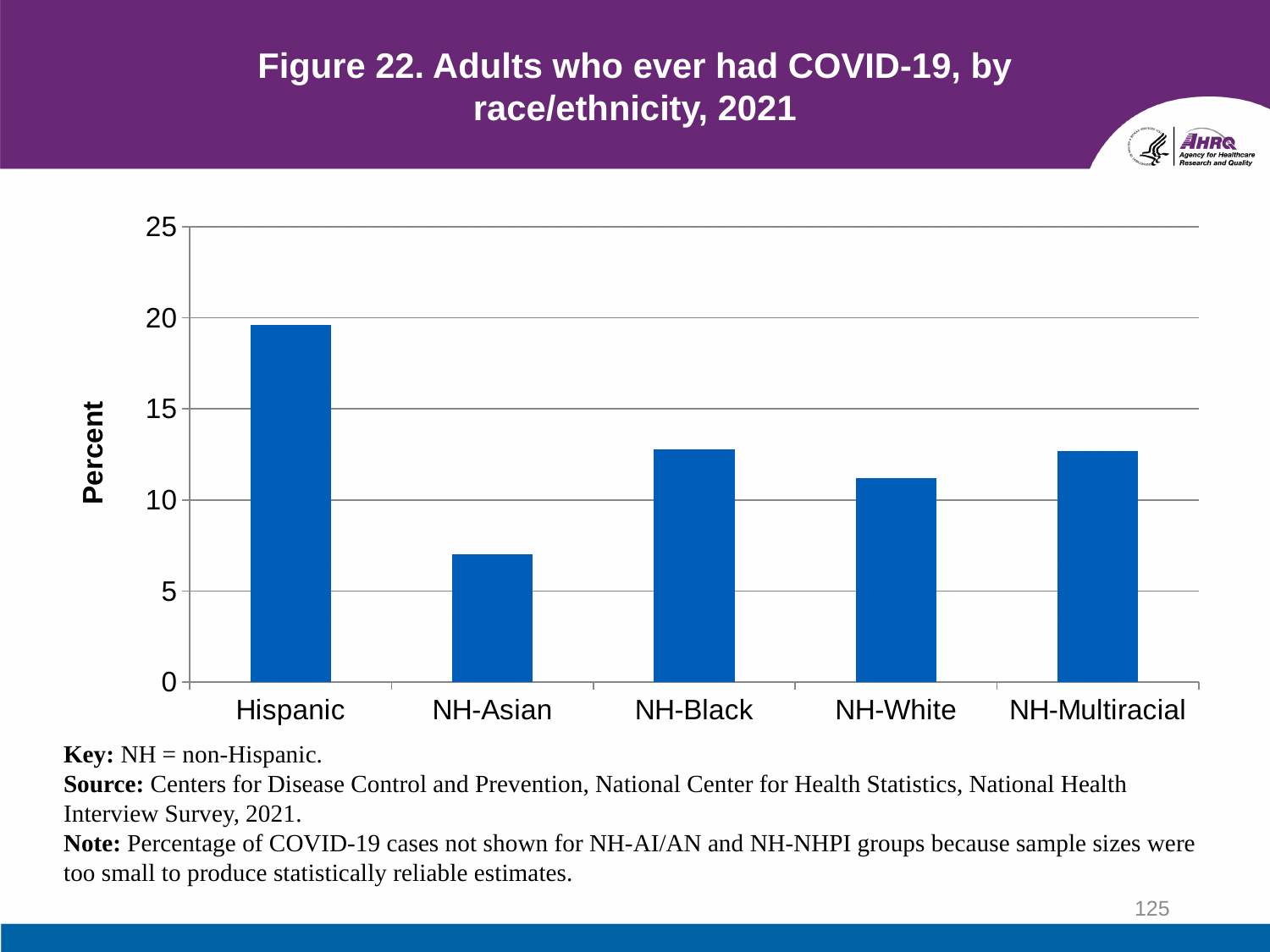
Is the value for NH-Asian greater or less than 10? less Which race/ethnicity group has the lowest percentage of adults who ever had COVID-19? NH-Asian What is the label on the vertical axis of the chart? Percent Which is larger, the value for NH-Asian or the value for NH-Black? NH-Black What kind of chart is shown on the slide? Bar chart Is the value for Hispanic greater or less than 15? greater Is the value for NH-Black greater or less than 10? greater Which is larger, the value for Hispanic or the value for NH-White? Hispanic Which race/ethnicity group has the highest percentage of adults who ever had COVID-19? Hispanic How many race/ethnicity categories are shown in the chart? 5